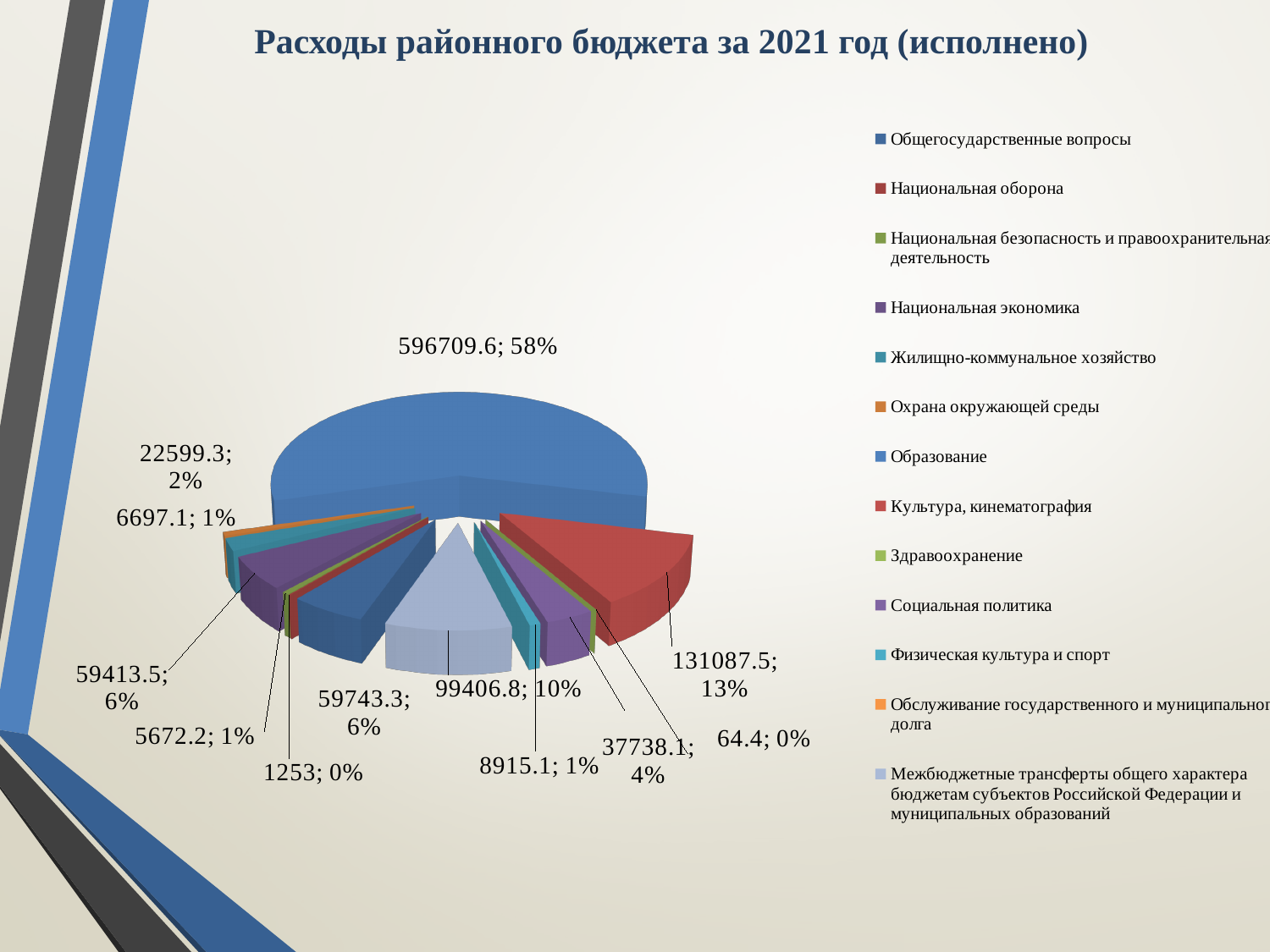
What share of the pie does the slice with value 22599.3 represent? 2% Which is larger: the slice with value 59743.3 or the slice with value 37738.1? 59743.3 How many categories does the legend list? 13 What is the difference between the slice values 131087.5 and 99406.8? 31680.7 What is the value of the slice labelled 13%? 131087.5 What share of the pie does the largest slice (596709.6) represent? 58% What kind of chart is shown on the slide? pie chart What is the smallest value printed on the pie? 64.4 What share of the pie does the slice with value 99406.8 represent? 10% What is the value of the largest slice of the pie? 596709.6 Which category does the largest slice (58%) belong to? Образование What is the title of the chart? Расходы районного бюджета за 2021 год (исполнено)